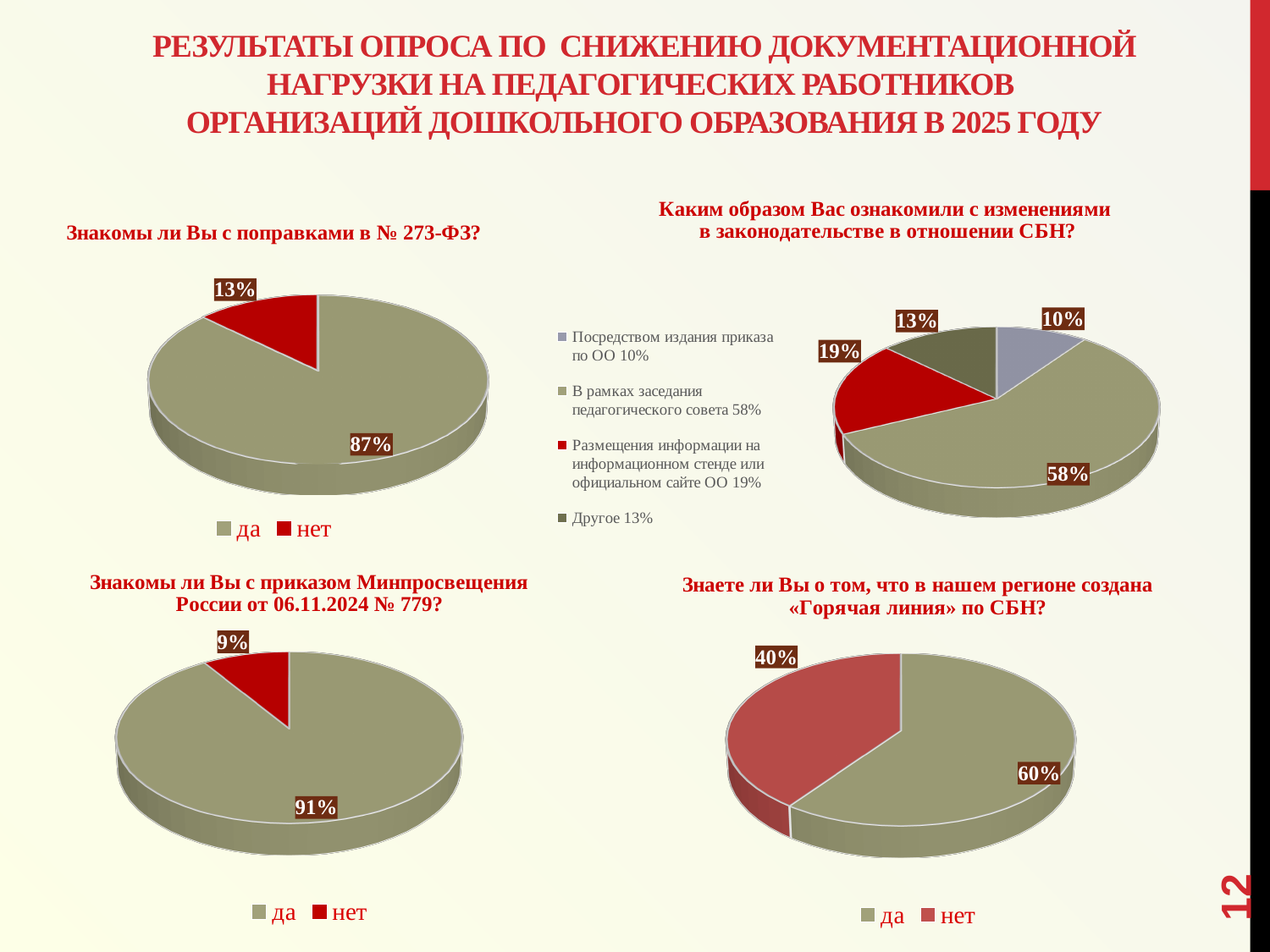
In the bottom-right chart 'Знаете ли Вы о том, что в нашем регионе создана «Горячая линия» по СБН?', which answer has the larger share, 'да' or 'нет'? да In the top-left chart 'Знакомы ли Вы с поправками в № 273-ФЗ?', what share of respondents answered 'да'? 87% What type of chart is the bottom-right chart 'Знаете ли Вы о том, что в нашем регионе создана «Горячая линия» по СБН?'? Pie chart In the top-left chart 'Знакомы ли Вы с поправками в № 273-ФЗ?', what share of respondents answered 'нет'? 13% In the top-right chart 'Каким образом Вас ознакомили с изменениями в законодательстве в отношении СБН?', what is the share for 'Посредством издания приказа по ОО'? 10% In the bottom-left chart 'Знакомы ли Вы с приказом Минпросвещения России от 06.11.2024 № 779?', what share of respondents answered 'да'? 91% In the top-right chart 'Каким образом Вас ознакомили с изменениями в законодательстве в отношении СБН?', which category has the largest share? В рамках заседания педагогического совета In the bottom-right chart 'Знаете ли Вы о том, что в нашем регионе создана «Горячая линия» по СБН?', what share of respondents answered 'нет'? 40% In the top-right chart 'Каким образом Вас ознакомили с изменениями в законодательстве в отношении СБН?', which category has the smallest share? Посредством издания приказа по ОО In the bottom-left chart 'Знакомы ли Вы с приказом Минпросвещения России от 06.11.2024 № 779?', what is the difference between the 'да' and 'нет' shares? 82% How many categories does the legend of the top-right chart 'Каким образом Вас ознакомили с изменениями в законодательстве в отношении СБН?' list? 4 In the top-right chart 'Каким образом Вас ознакомили с изменениями в законодательстве в отношении СБН?', what is the share for 'В рамках заседания педагогического совета'? 58%